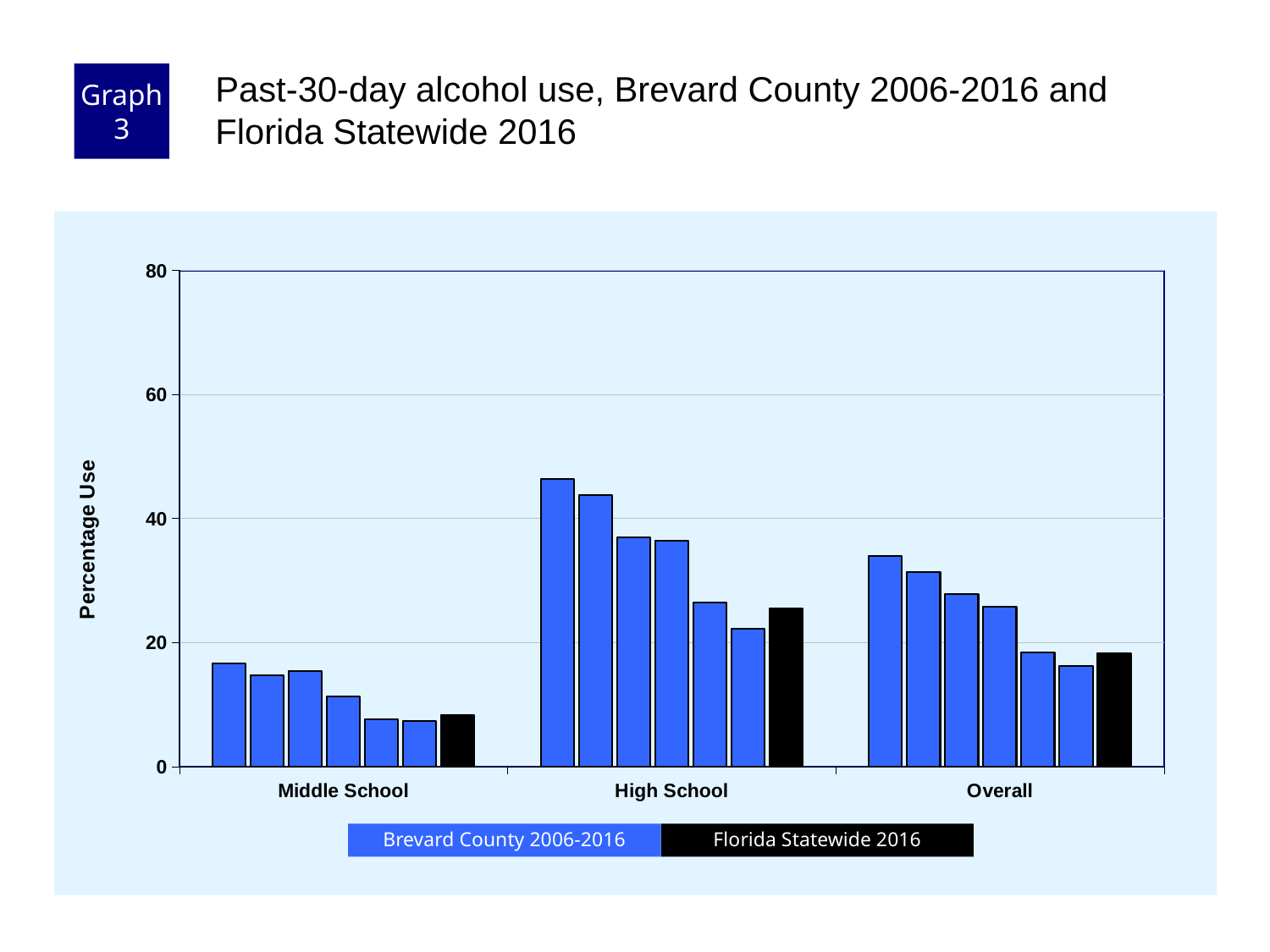
What kind of chart is shown on the slide? bar chart Which category has the highest Florida Statewide 2016 bar? High School What is the label of the y axis? Percentage Use Is the Florida Statewide 2016 value for Middle School greater or less than 20? less Is the Florida Statewide 2016 value for High School greater or less than 20? greater Which is larger, the Florida Statewide 2016 value for High School or for Overall? High School How many categories are shown on the x axis? 3 Within the High School group, do the Brevard County 2006-2016 bars rise or fall from left to right? fall How many series does the legend list? 2 Which category has the lowest Florida Statewide 2016 bar? Middle School Is the tallest Brevard County bar for High School greater or less than 40? greater Which colour represents Florida Statewide 2016 in the legend? black